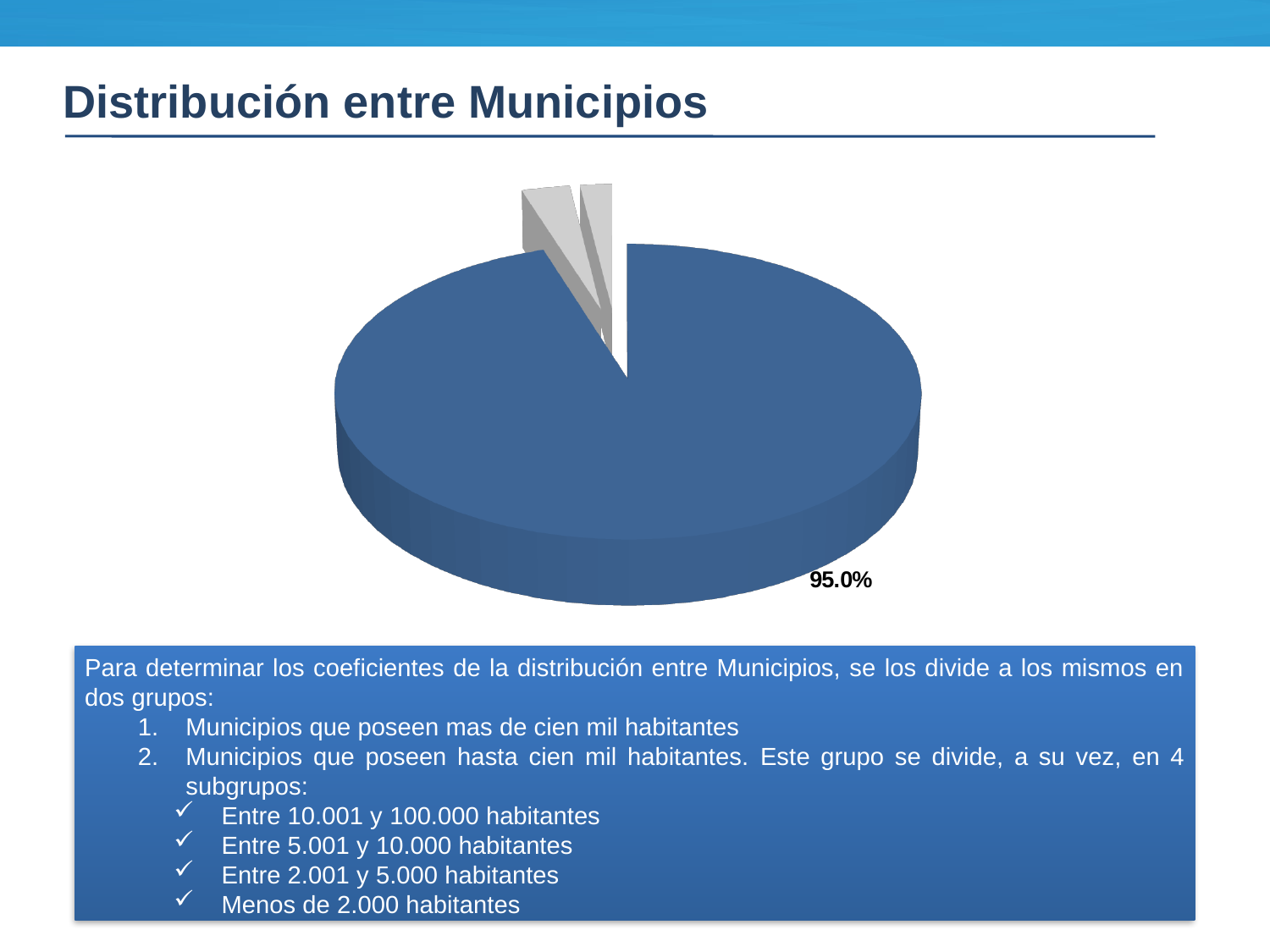
What kind of chart is shown on the slide? Pie chart Is the blue slice of the pie chart greater or less than 50% of the pie? greater How many slices does the pie chart have? 3 What colour are the two small slices of the pie chart? Grey Which is larger, the blue slice or either of the grey slices? The blue slice What percentage is printed on the large blue slice of the pie chart? 95.0% Which slice of the pie chart is the largest? The blue slice (95.0%) Does the pie chart include a legend? No What share of the pie does the blue slice represent? 95.0%